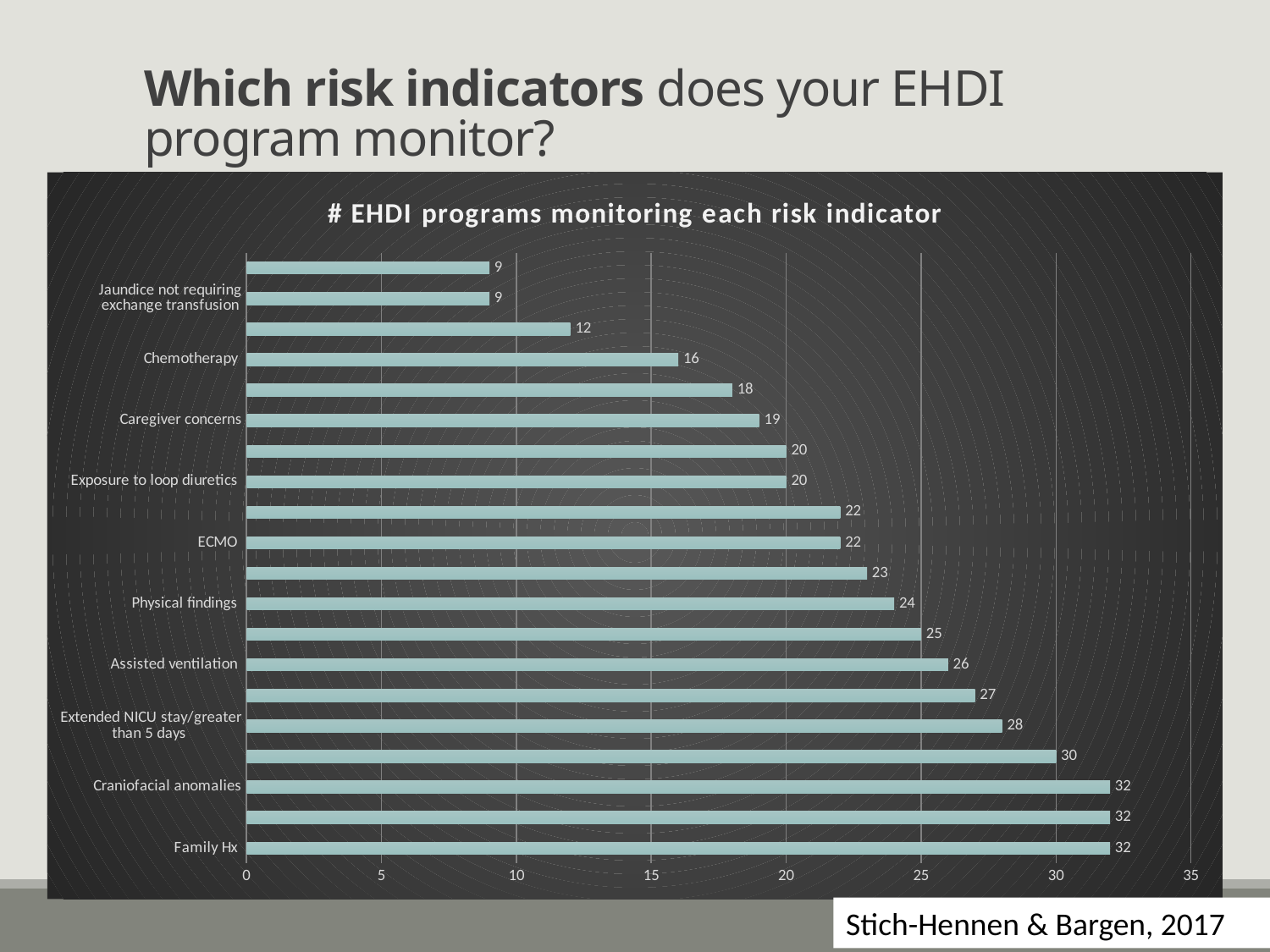
Is the value for Craniofacial anomalies greater or less than 30? greater What is the title of the chart? # EHDI programs monitoring each risk indicator How many EHDI programs monitor Extended NICU stay/greater than 5 days? 28 How many EHDI programs monitor Jaundice not requiring exchange transfusion? 9 What is the smallest value shown on any bar in the chart? 9 How many bars are plotted in the chart? 20 How many EHDI programs monitor ECMO? 22 How many EHDI programs monitor Family Hx? 32 What is the difference between the number of programs monitoring Assisted ventilation and the number monitoring Physical findings? 2 Which is monitored by more programs, Caregiver concerns or Exposure to loop diuretics? Exposure to loop diuretics How many EHDI programs monitor Chemotherapy? 16 What type of chart is shown on the slide? Bar chart